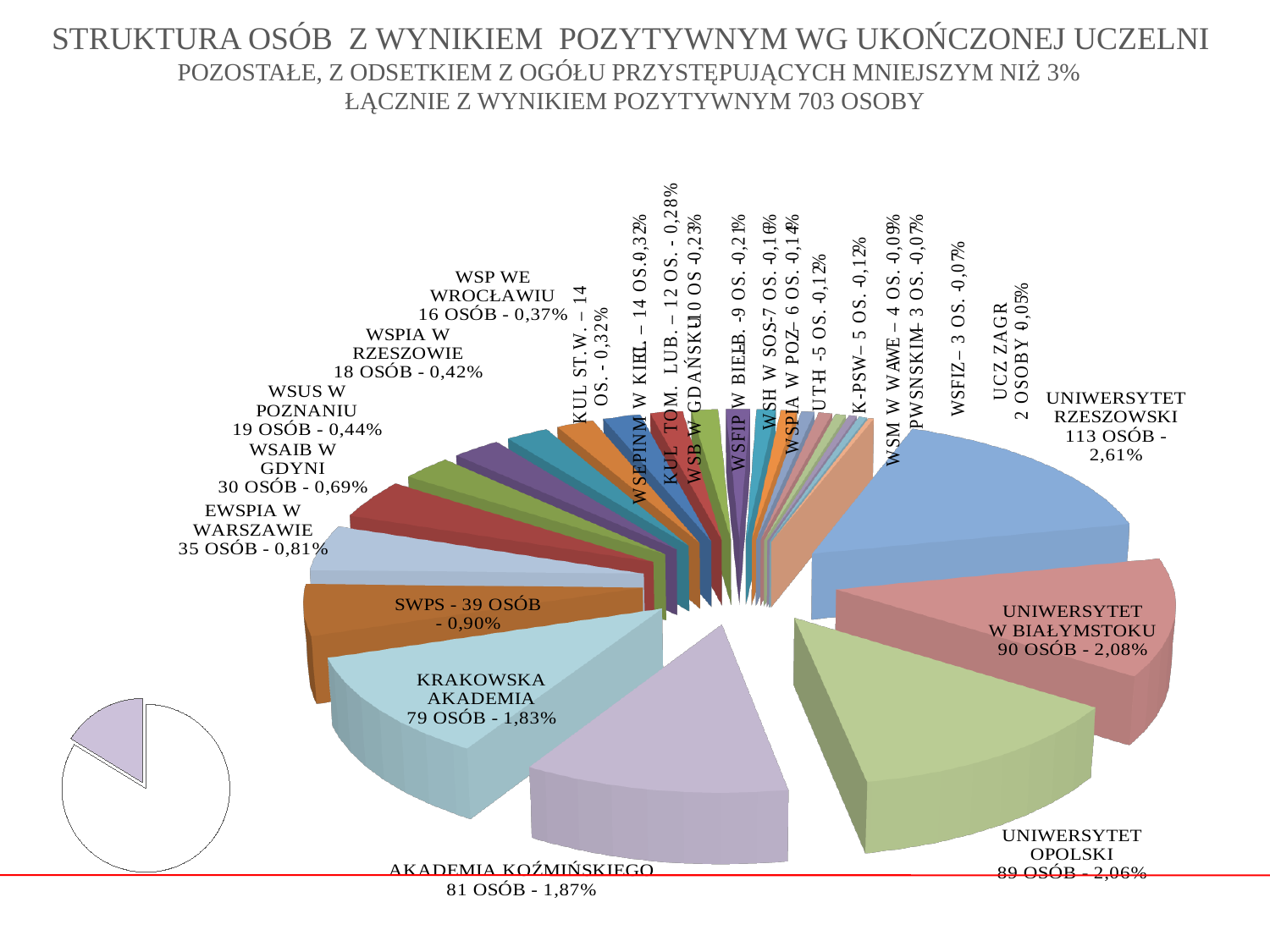
Which university has the largest slice of the pie? UNIWERSYTET RZESZOWSKI Which category has the smallest slice of the pie? UCZ ZAGR How many people in total had a positive result according to the chart title? 703 OSOBY What share of the pie does WSAIB W GDYNI represent? 0,69% What kind of chart is shown on the slide? pie chart How many people with a positive result are shown for UNIWERSYTET RZESZOWSKI? 113 OSÓB How many people are shown for KRAKOWSKA AKADEMIA? 79 OSÓB What is the difference in number of people between UNIWERSYTET RZESZOWSKI and UNIWERSYTET OPOLSKI? 24 Which has more people: AKADEMIA KOŹMIŃSKIEGO or EWSPIA W WARSZAWIE? AKADEMIA KOŹMIŃSKIEGO What percentage is shown for SWPS? 0,90% How many people are shown for WSUS W POZNANIU? 19 OSÓB What percentage is shown for UNIWERSYTET W BIAŁYMSTOKU? 2,08%